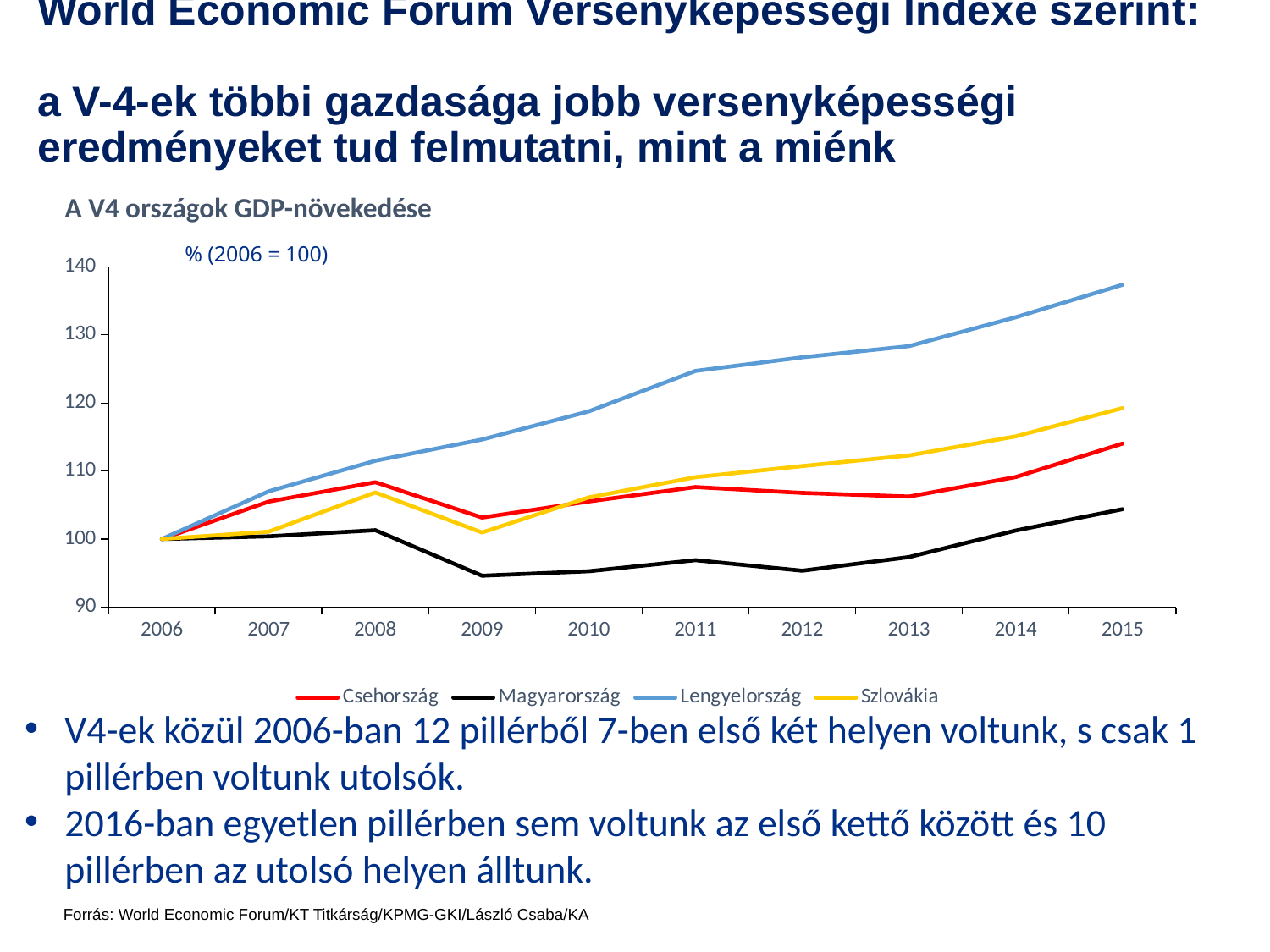
Is the value for Magyarország in 2009 greater or less than 100? less What is the value for Magyarország in 2006? 100 How many series does the legend list? 4 Which country has the highest value in 2015? Lengyelország Does the value for Lengyelország rise or fall from 2006 to 2015? rise How many years are plotted along the x axis? 10 Which country has the lowest value in 2015? Magyarország Is the value for Lengyelország in 2015 greater or less than 130? greater What kind of chart is shown on the slide? line chart In 2015, which is larger: the value for Szlovákia or the value for Csehország? Szlovákia What is the title of the chart? A V4 országok GDP-növekedése Is the value for Lengyelország in 2011 greater or less than 120? greater